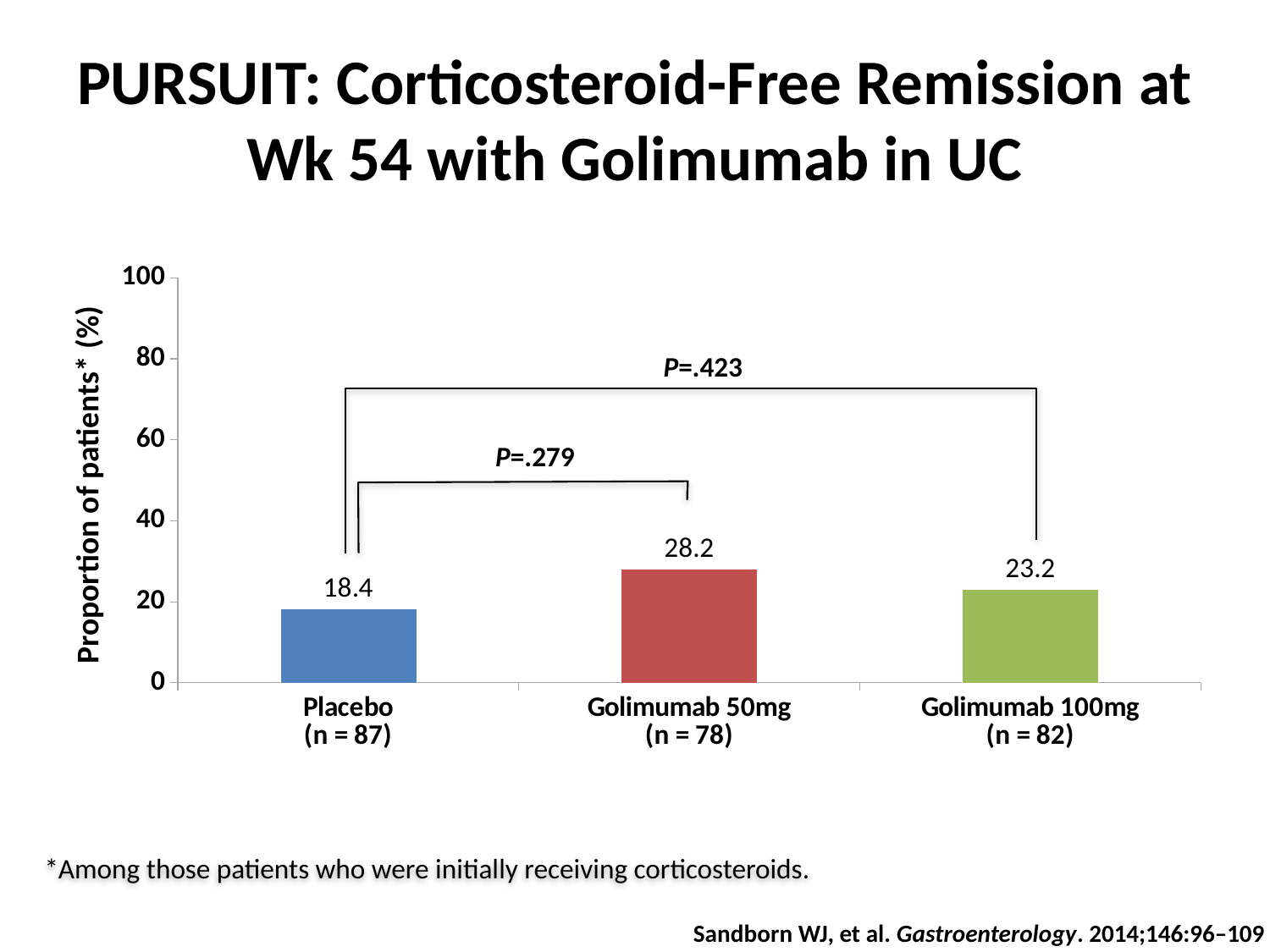
Which has a larger proportion of patients in remission, Golimumab 100mg or Placebo? Golimumab 100mg What is the proportion of patients in corticosteroid-free remission for Placebo (n = 87)? 18.4 What kind of chart is shown on the slide? Bar chart Is the value for Golimumab 50mg greater or less than 20? greater Which group has the highest proportion of patients in corticosteroid-free remission? Golimumab 50mg Which group has the lowest proportion of patients in corticosteroid-free remission? Placebo What is the proportion of patients in corticosteroid-free remission for Golimumab 100mg (n = 82)? 23.2 What is the difference in proportion of patients between Golimumab 50mg and Golimumab 100mg? 5.0 What is the P value shown for the comparison between Placebo and Golimumab 100mg? P=.423 How many treatment groups are shown in the chart? 3 What is the proportion of patients in corticosteroid-free remission for Golimumab 50mg (n = 78)? 28.2 What is the difference in proportion of patients between Golimumab 50mg and Placebo? 9.8